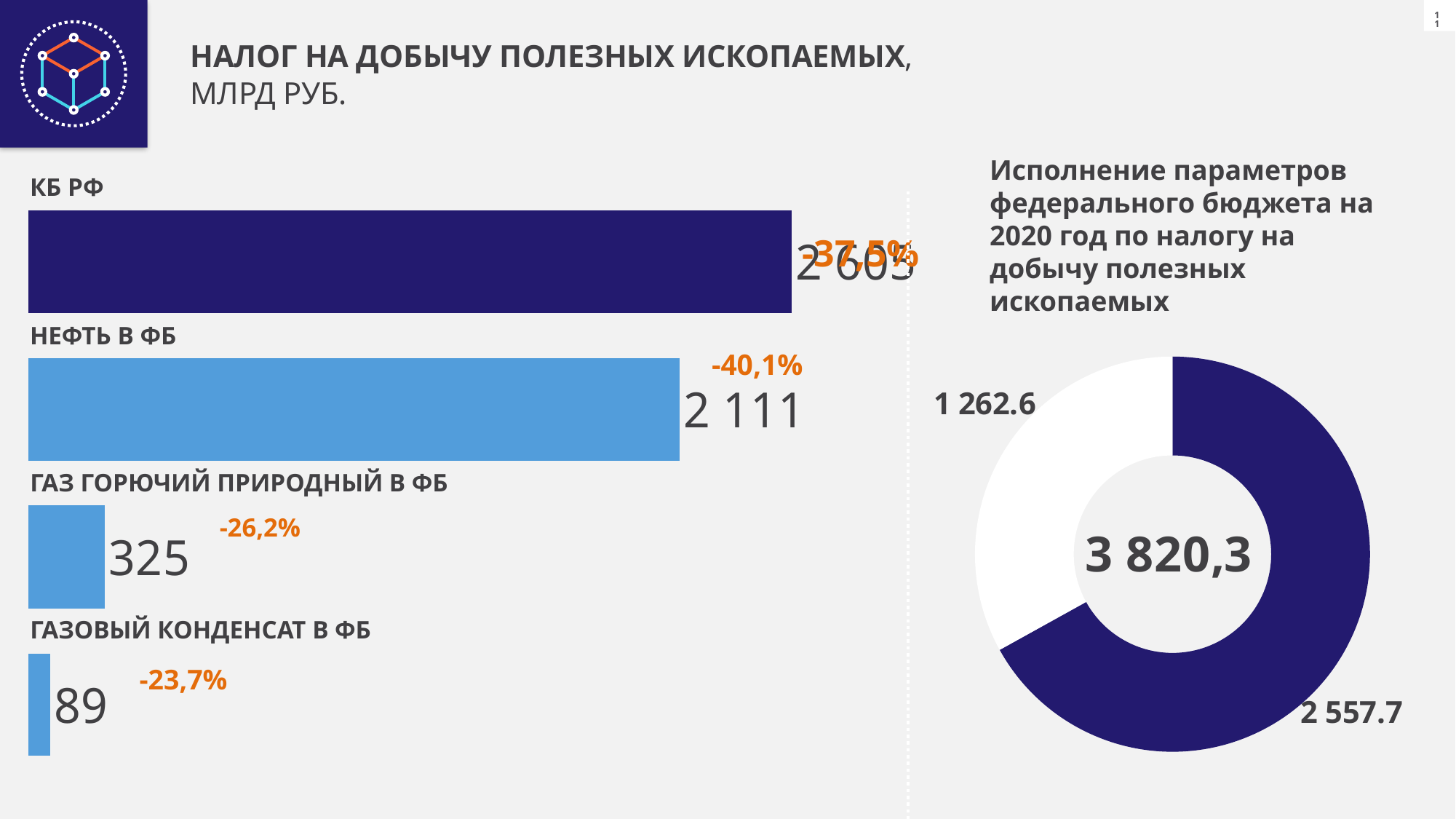
On the bar chart on the left, what is the value for НЕФТЬ В ФБ? 2 111 On the bar chart on the left, what percentage change is shown next to the НЕФТЬ В ФБ bar? -40,1% On the donut chart on the right, which slice is larger: the one labelled 2 557.7 or the one labelled 1 262.6? 2 557.7 What kind of chart is shown on the right side of the slide? Donut (pie) chart On the bar chart on the left, what is the value for ГАЗОВЫЙ КОНДЕНСАТ В ФБ? 89 On the bar chart on the left, what percentage change is shown next to the ГАЗОВЫЙ КОНДЕНСАТ В ФБ bar? -23,7% On the bar chart on the left, what is the difference between the values for НЕФТЬ В ФБ and ГАЗ ГОРЮЧИЙ ПРИРОДНЫЙ В ФБ? 1 786 On the donut chart on the right, what value is shown in the centre? 3 820,3 On the bar chart on the left, which category has the smallest value? ГАЗОВЫЙ КОНДЕНСАТ В ФБ On the bar chart on the left, how many categories are shown? 4 On the bar chart on the left, what is the value for ГАЗ ГОРЮЧИЙ ПРИРОДНЫЙ В ФБ? 325 On the bar chart on the left, which category has the longest bar? КБ РФ